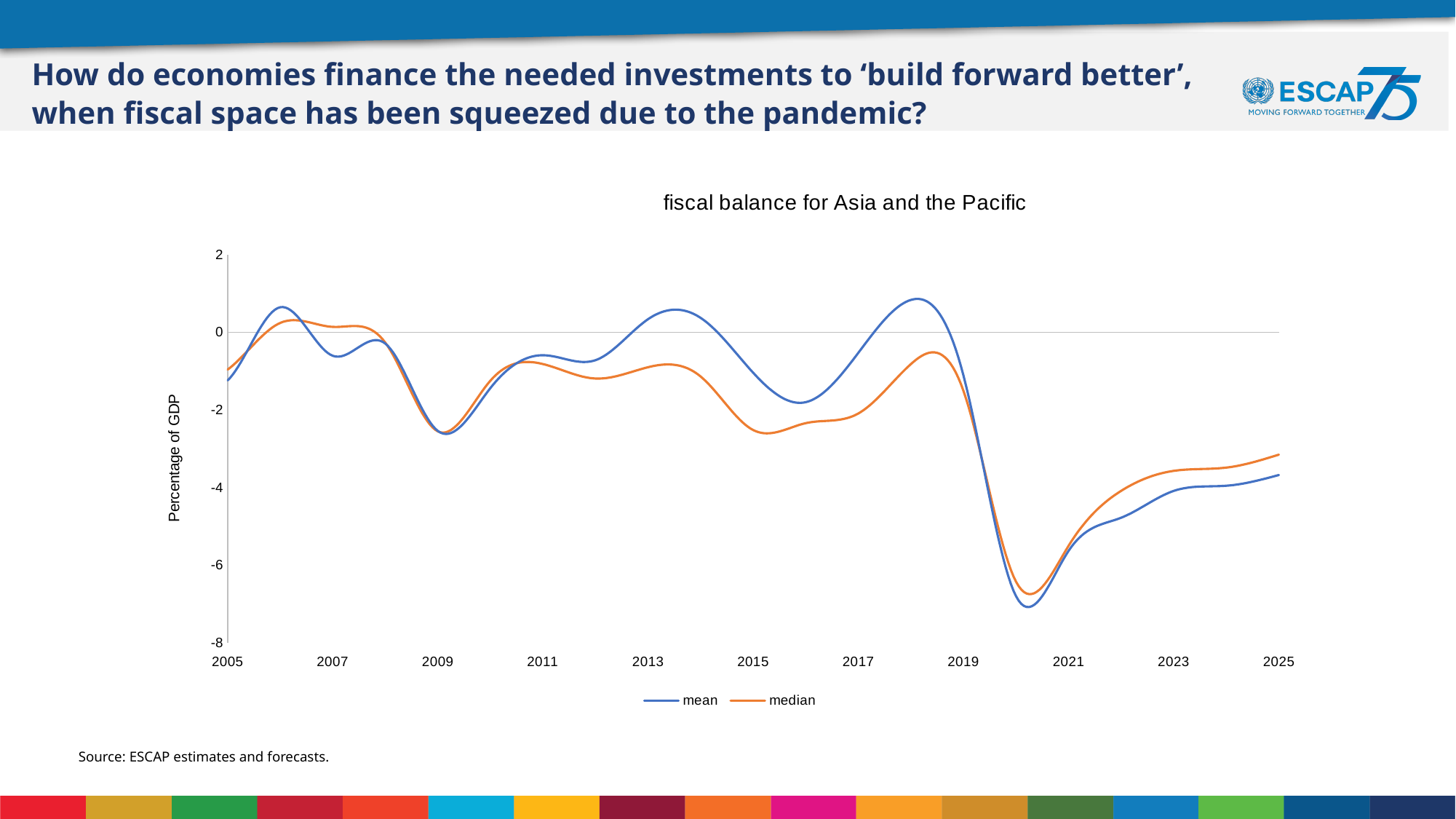
Is the value of the mean series in 2005 greater or less than 0? less In 2025, which series has the higher value, mean or median? median How many series does the legend list? 2 What is the label on the vertical axis? Percentage of GDP What is the title of the chart? fiscal balance for Asia and the Pacific Do the values of the mean series rise or fall between 2021 and 2025? rise In 2015, which series has the higher value, mean or median? mean Is the value of the median series in 2025 greater or less than -4? greater What kind of chart is shown on the slide? line chart Is the value of the mean series in 2021 greater or less than -4? less